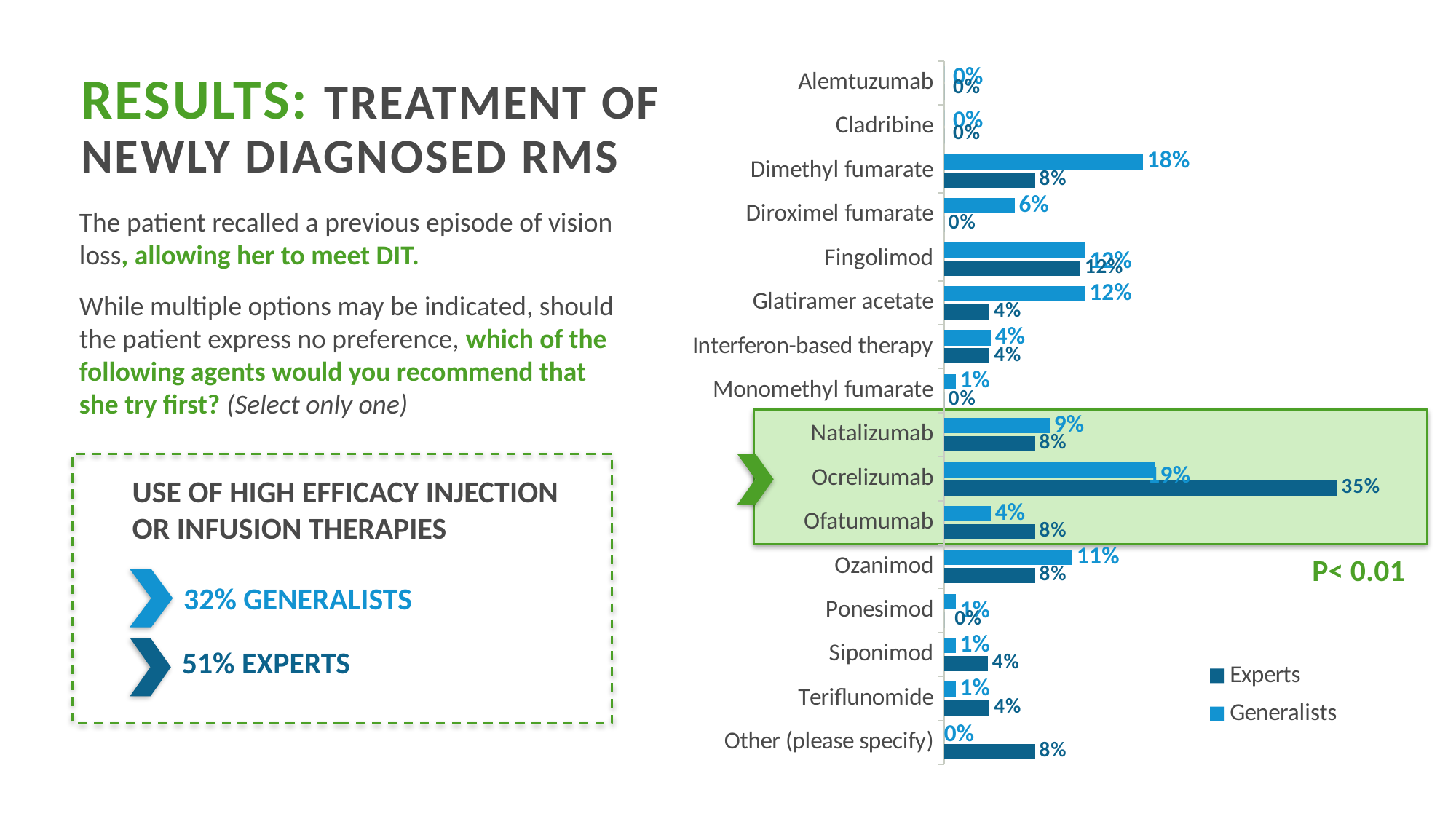
How many agents (categories) are listed on the chart? 16 What percentage of Generalists recommended Dimethyl fumarate? 18% What is the difference between the Generalists and Experts values for Glatiramer acetate? 8% What percentage of Experts recommended Ocrelizumab? 35% What percentage of Generalists recommended Ozanimod? 11% How many series does the chart legend list? 2 Which agent has the highest value for Experts? Ocrelizumab What percentage of Experts recommended Ofatumumab? 8% For Dimethyl fumarate, which group has the larger value, Experts or Generalists? Generalists What kind of chart is shown on the slide? bar chart Which series is shown in dark blue in the legend? Experts What is the difference between the Experts and Generalists values for Ocrelizumab? 16%